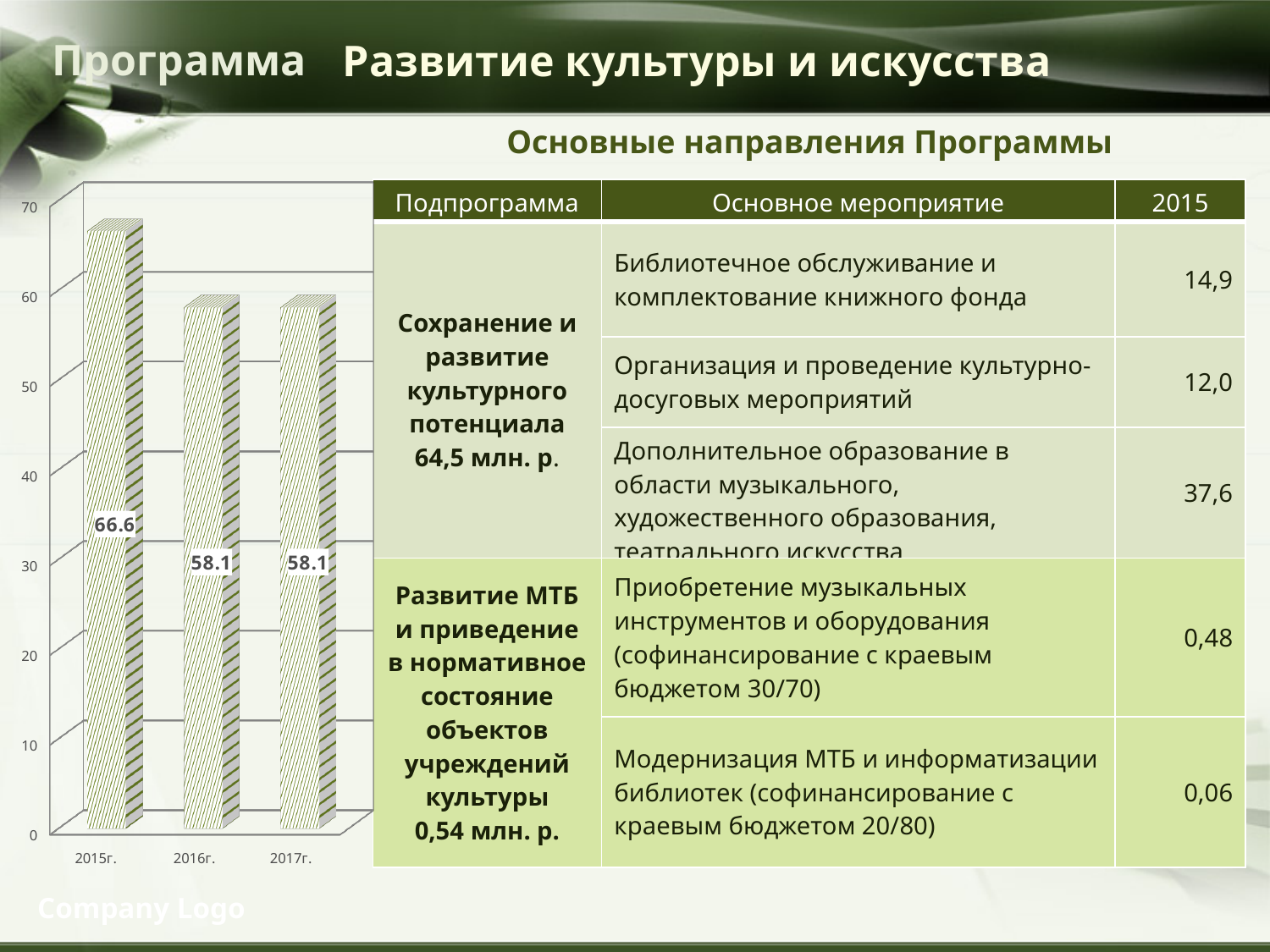
What is the difference between the values for 2015г. and 2016г.? 8.5 What kind of chart is shown on the slide? bar chart What is the value for 2016г.? 58.1 Do the values rise or fall from 2015г. to 2016г.? fall Is the value for 2016г. greater or less than 60? less Which is larger, the value for 2015г. or the value for 2017г.? 2015г. Is the value for 2015г. greater or less than 60? greater What is the value for 2017г.? 58.1 How many years are shown on the x axis of the chart? 3 What is the highest tick value shown on the vertical axis of the chart? 70 What is the value for 2015г.? 66.6 Which year has the highest value? 2015г.